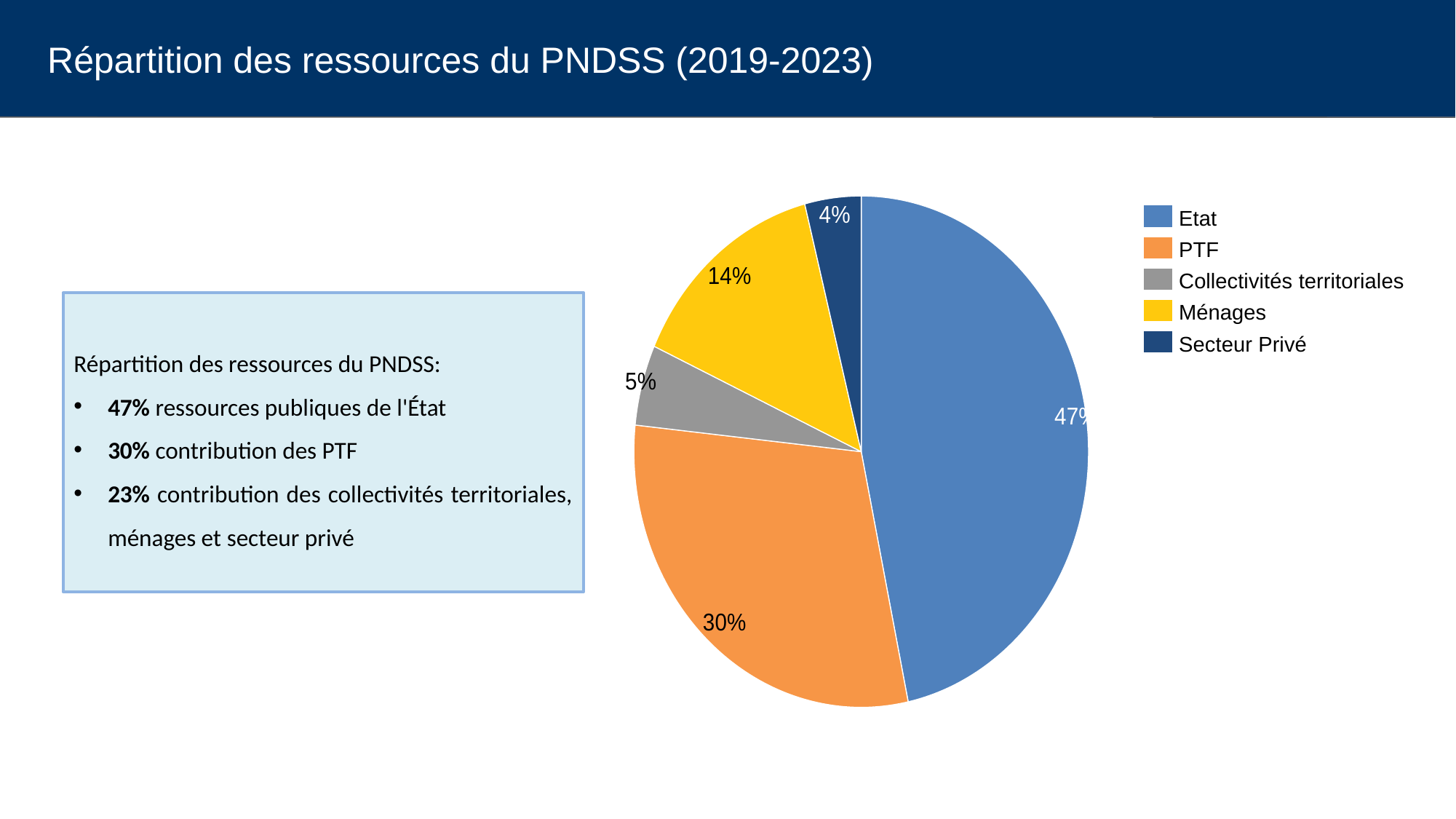
How many categories does the legend list? 5 What share of the pie does Collectivités territoriales represent? 5% What colour is the slice for Ménages? yellow What kind of chart is shown on the slide? pie chart What share of the pie does PTF represent? 30% What is the difference between the shares of Etat and PTF? 17% Which is larger, the share of Ménages or the share of Collectivités territoriales? Ménages Which category has the largest slice of the pie? Etat What share of the pie does Ménages represent? 14% What share of the pie does Secteur Privé represent? 4% Which category has the smallest slice of the pie? Secteur Privé What share of the pie does Etat represent? 47%